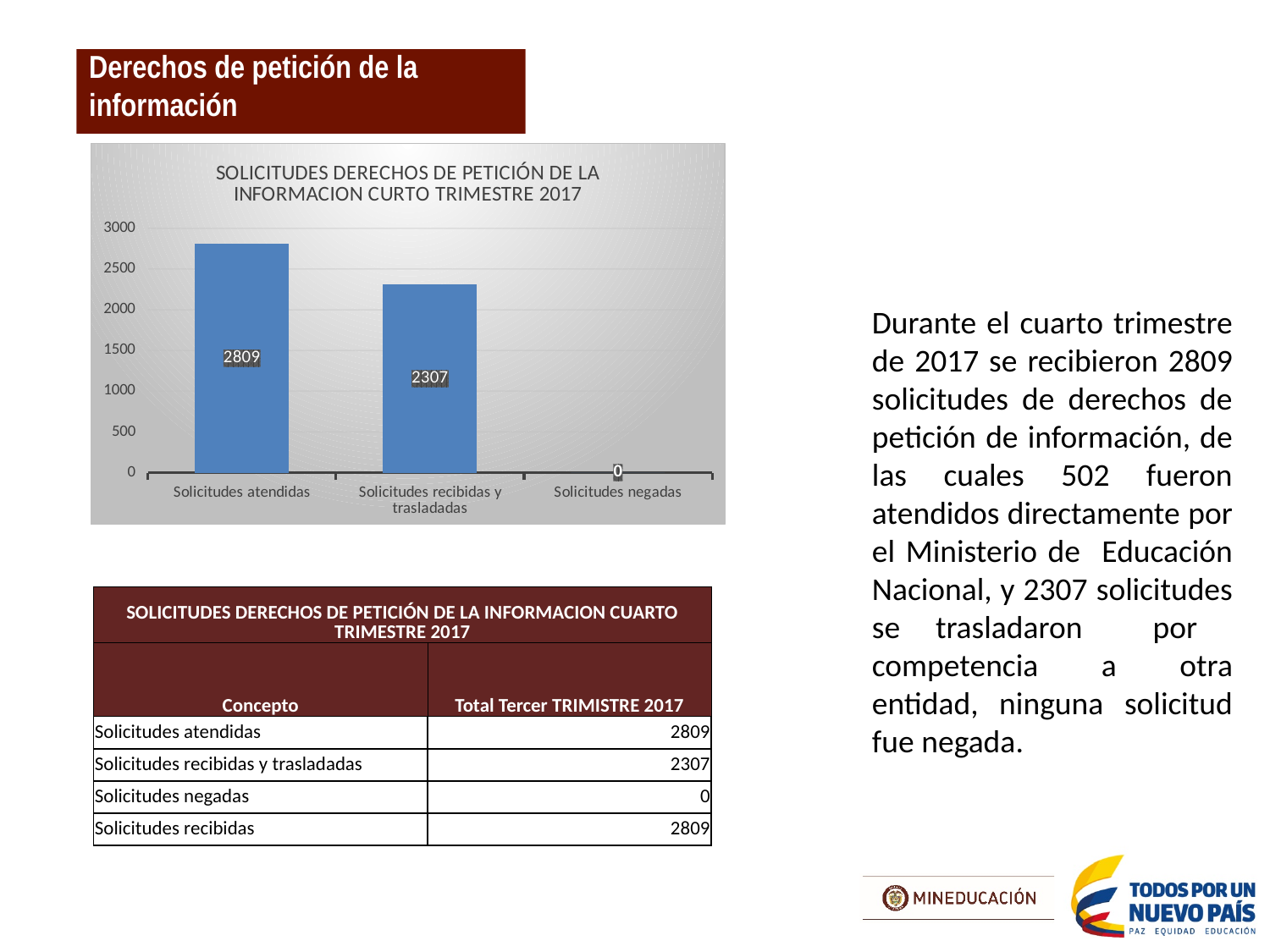
What is the value for Solicitudes negadas? 0 Which category has the lowest value? Solicitudes negadas What is the value for Solicitudes atendidas? 2809 What is the difference between Solicitudes atendidas and Solicitudes recibidas y trasladadas? 502 How many categories are shown on the x axis of the chart? 3 Which category has the highest value? Solicitudes atendidas What is the value for Solicitudes recibidas y trasladadas? 2307 Which is larger, Solicitudes atendidas or Solicitudes recibidas y trasladadas? Solicitudes atendidas What kind of chart is shown on the slide? Bar chart Is the value for Solicitudes recibidas y trasladadas greater or less than 2500? less Is the value for Solicitudes atendidas greater or less than 2500? greater What is the title of the chart? SOLICITUDES DERECHOS DE PETICIÓN DE LA INFORMACION CURTO TRIMESTRE 2017